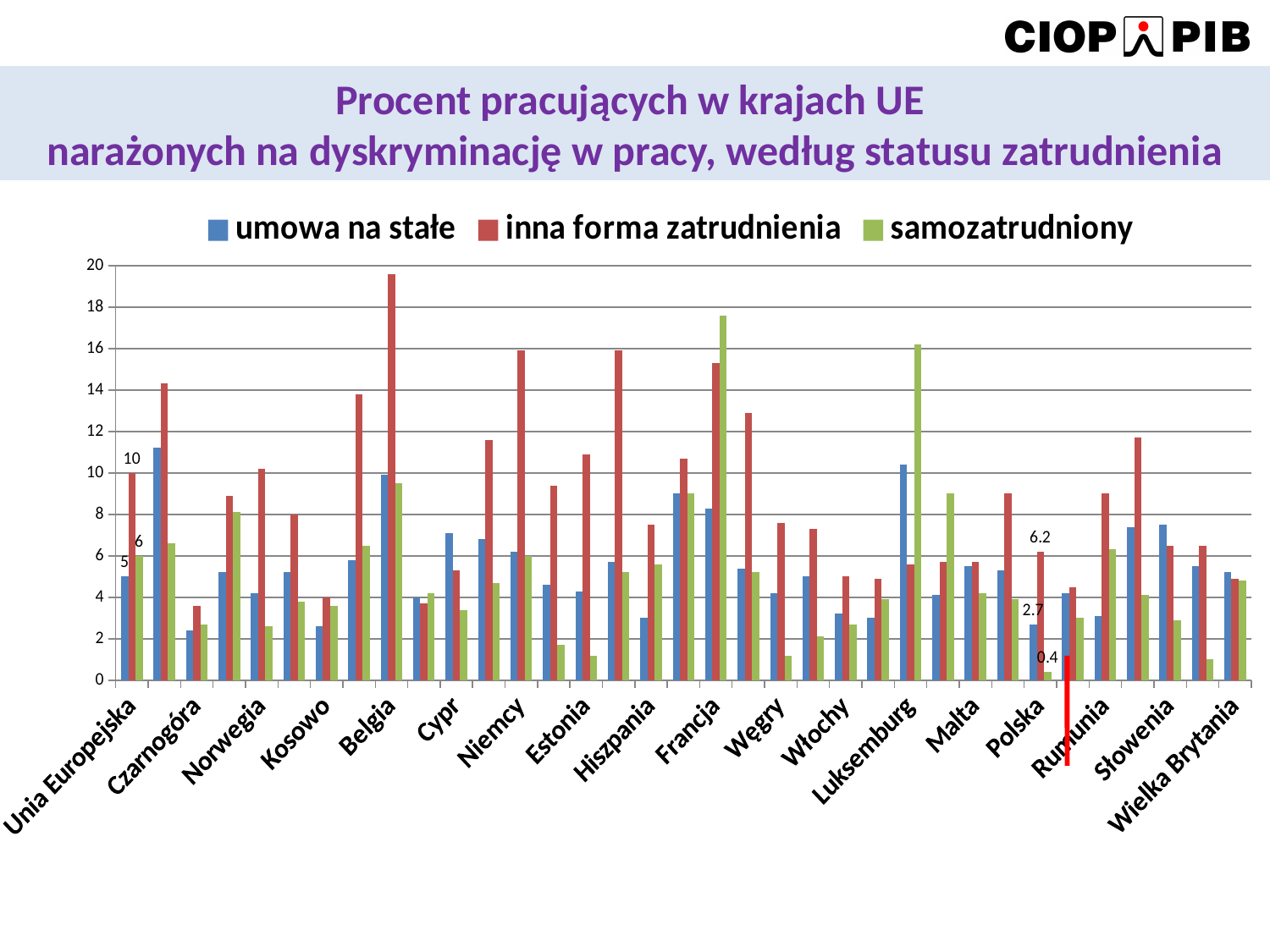
What is the difference between 'inna forma zatrudnienia' and 'umowa na stałe' for Unia Europejska? 5 For Polska, which is larger: 'umowa na stałe' or 'samozatrudniony'? umowa na stałe What is the value for 'umowa na stałe' for Unia Europejska? 5 What is the value for 'inna forma zatrudnienia' for Polska? 6.2 Is the value for 'samozatrudniony' for Luksemburg greater or less than 14? greater What kind of chart is shown on the slide? bar chart What is the value for 'samozatrudniony' for Polska? 0.4 How many series does the legend list? 3 Which series has the highest value for Unia Europejska? inna forma zatrudnienia What is the value for 'inna forma zatrudnienia' for Unia Europejska? 10 Is the value for 'inna forma zatrudnienia' for Belgia greater or less than 18? greater What is the difference between 'inna forma zatrudnienia' and 'umowa na stałe' for Polska? 3.5